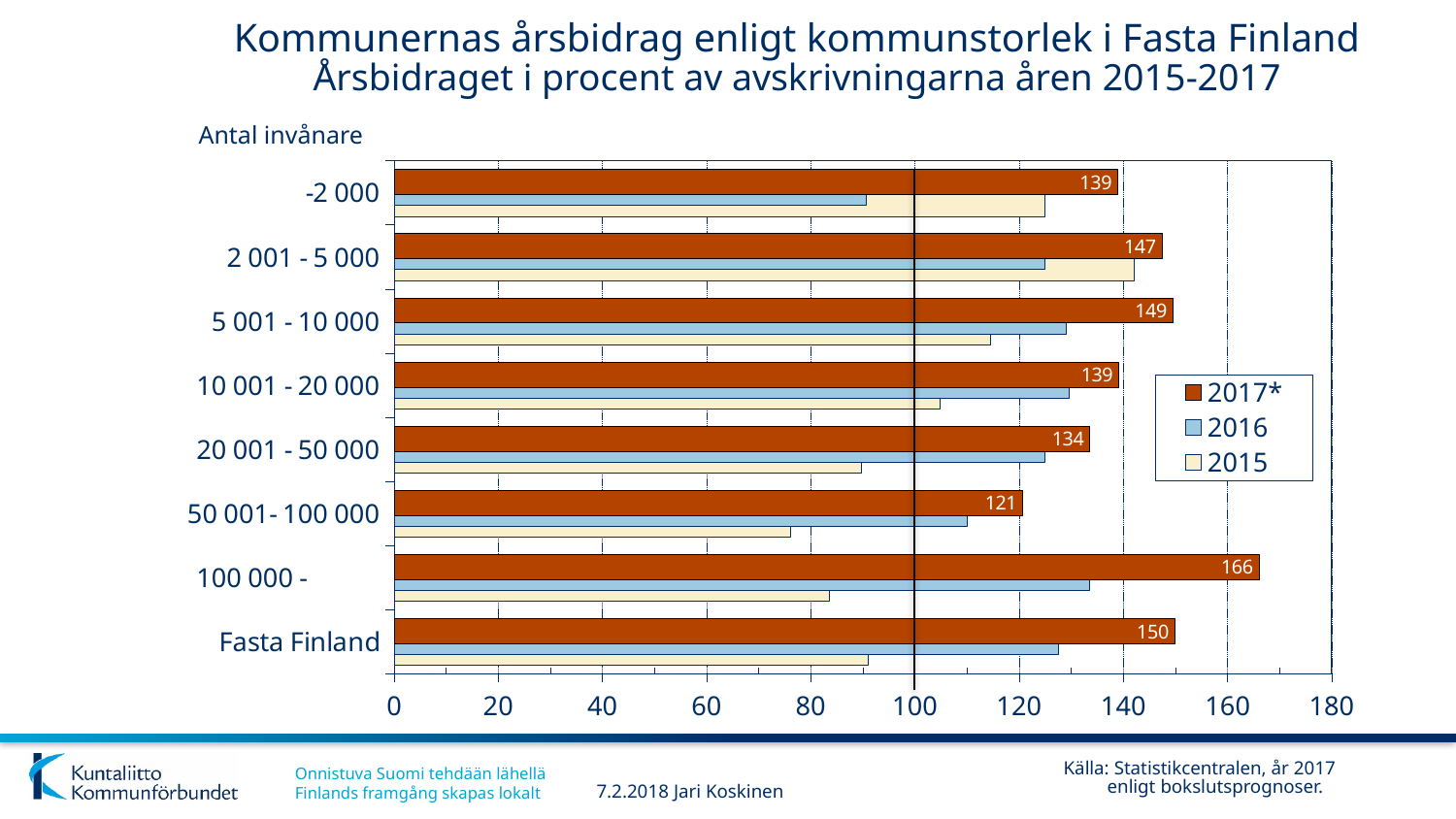
What is the 2017* value for the "50 001- 100 000" category? 121 What is the 2017* value for "Fasta Finland"? 150 Is the 2016 value for "100 000 -" greater or less than 120? greater What is the difference between the 2017* values for "100 000 -" and "50 001- 100 000"? 45 How many series does the legend list? 3 What is the 2017* value for the "100 000 -" category? 166 What kind of chart is shown on the slide? bar chart Which category has the lowest 2017* value? 50 001- 100 000 How many categories are shown on the vertical axis? 8 Which has the larger 2017* value: "2 001 - 5 000" or "20 001 - 50 000"? 2 001 - 5 000 Which category has the highest 2017* value? 100 000 - Is the 2015 value for "50 001- 100 000" greater or less than 80? less